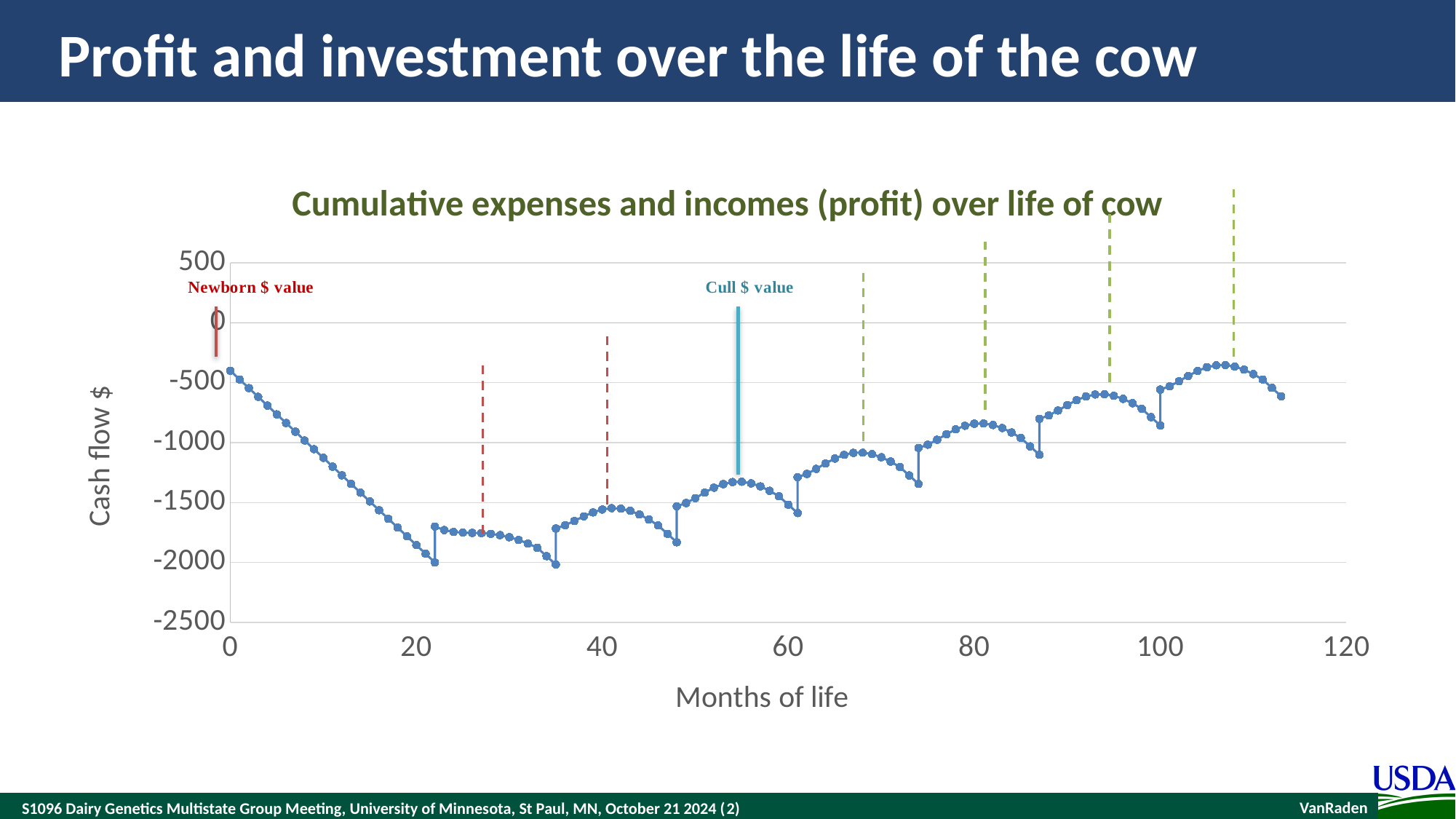
Is the cash flow value at month 22 greater or less than -1500? less Does the cash flow rise or fall between month 0 and month 20? Fall What is the title of the chart? Cumulative expenses and incomes (profit) over life of cow Is the cash flow value at month 80 greater or less than -1000? greater Which has the larger cash flow value, month 20 or month 100? Month 100 Is the cash flow value at month 107 greater or less than -500? greater Which has the larger cash flow value, month 40 or month 80? Month 80 Does the cash flow generally rise or fall between month 60 and month 105? Rise What kind of chart is shown on the slide? Line chart What does the solid blue vertical line on the chart represent? Cull $ value